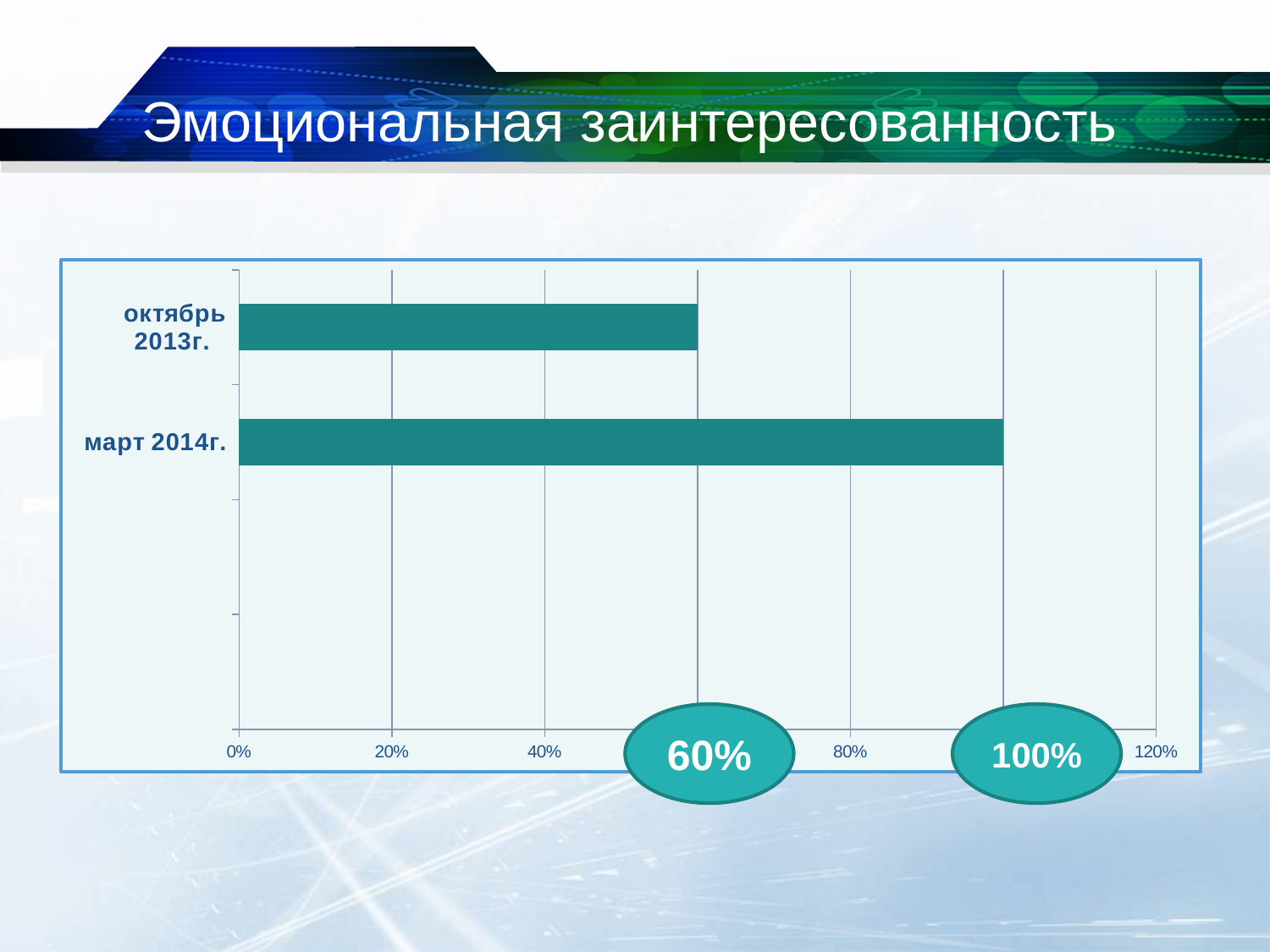
What type of chart is shown on the slide? bar chart Which category has the highest value? март 2014г. What is the title of the slide containing the chart? Эмоциональная заинтересованность Which category has the lowest value? октябрь 2013г. What is the difference between the values for март 2014г. and октябрь 2013г.? 40% What is the value for март 2014г.? 100% Is the value for октябрь 2013г. greater or less than 80%? less Is the value for март 2014г. greater or less than 80%? greater What is the value for октябрь 2013г.? 60% How many categories are shown in the chart? 2 Did the value rise or fall from октябрь 2013г. to март 2014г.? rise Which is larger, the value for октябрь 2013г. or the value for март 2014г.? март 2014г.